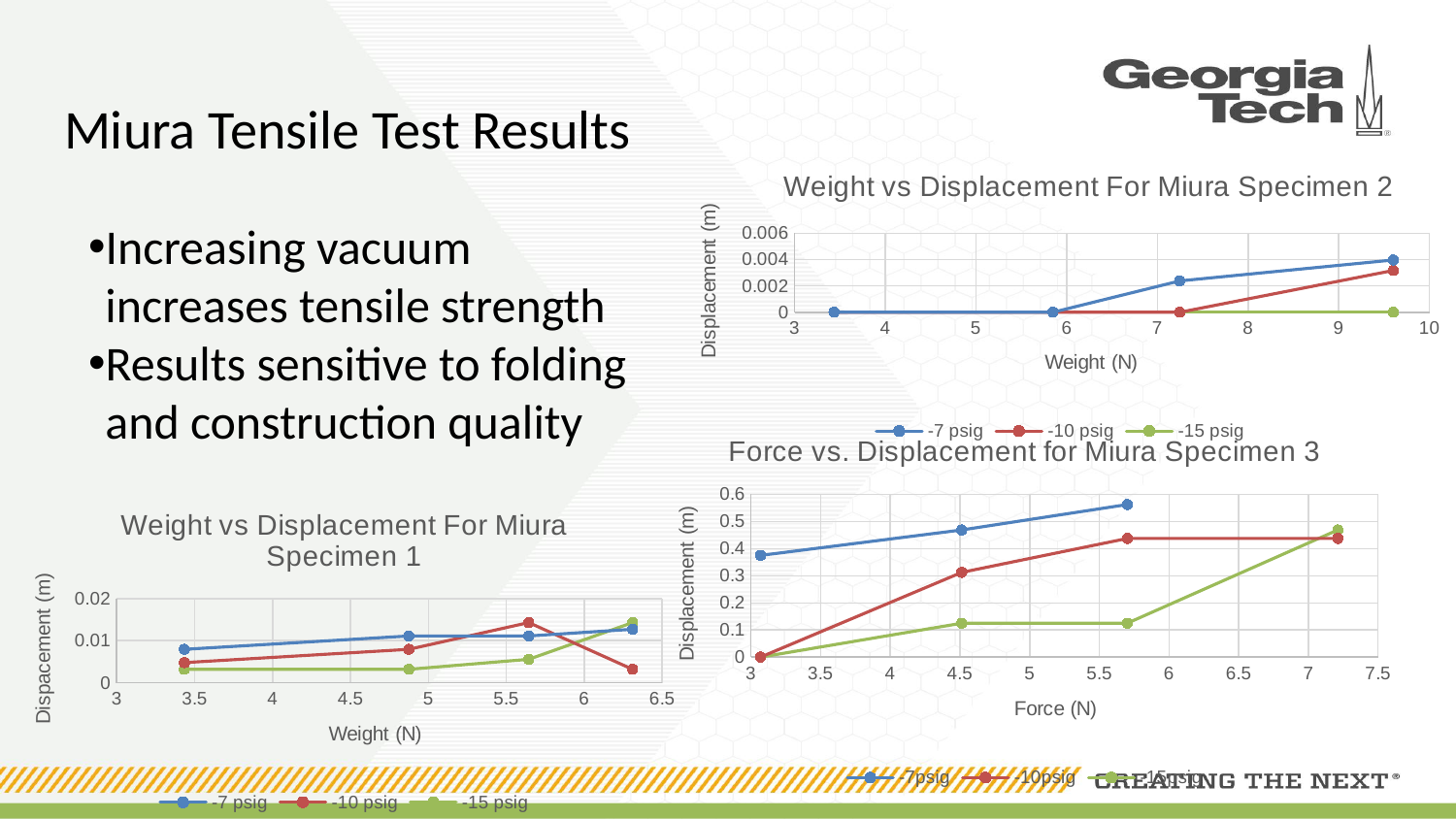
In "Weight vs Displacement For Miura Specimen 1", is the -10 psig displacement at a weight of about 5.65 N greater or less than 0.01? greater What is the x-axis label of the "Force vs. Displacement for Miura Specimen 3" chart? Force (N) How many series does the legend of "Weight vs Displacement For Miura Specimen 2" list? 3 In "Force vs. Displacement for Miura Specimen 3", which series has the highest displacement at a force of about 5.7 N? -7 psig In "Force vs. Displacement for Miura Specimen 3", which series has the lowest displacement at a force of about 5.7 N? -15 psig In "Force vs. Displacement for Miura Specimen 3", is the -7 psig displacement at a force of 3 N greater or less than 0.3? greater In "Weight vs Displacement For Miura Specimen 2", is the -7 psig displacement at the highest weight (about 9.6 N) greater or less than 0.002? greater What kind of chart is "Force vs. Displacement for Miura Specimen 3"? Line chart In "Force vs. Displacement for Miura Specimen 3", at a force of 4.5 N, which series has the larger displacement: -7 psig or -10 psig? -7 psig Which series are listed in the legend of "Weight vs Displacement For Miura Specimen 1"? -7 psig, -10 psig, -15 psig In "Force vs. Displacement for Miura Specimen 3", does the -7 psig displacement rise or fall as force increases? Rises